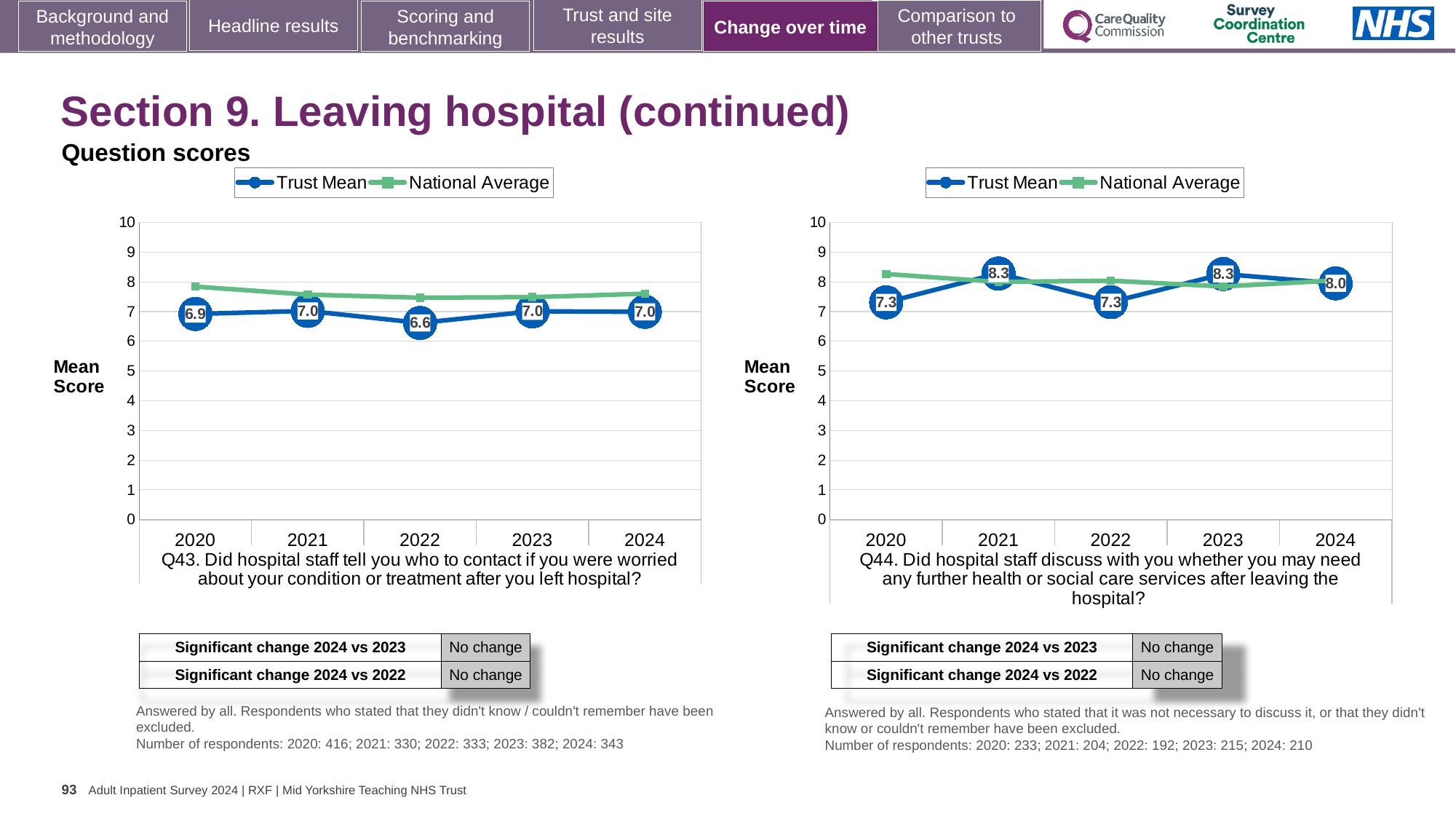
In the Q44 chart on the right, what is the Trust Mean score for 2024? 8.0 In the Q43 chart on the left, is the National Average for 2020 greater or less than 7? greater In the Q43 chart on the left, which is higher in 2022, the Trust Mean or the National Average? National Average In the Q43 chart on the left, what is the Trust Mean score for 2022? 6.6 What kind of chart is the Q43 chart on the left? line chart In the Q44 chart on the right, what is the Trust Mean score for 2021? 8.3 In the Q43 chart on the left, what is the difference between the Trust Mean scores for 2021 and 2022? 0.4 In the Q43 chart on the left, what is the Trust Mean score for 2020? 6.9 In the Q44 chart on the right, does the Trust Mean rise or fall from 2023 to 2024? fall How many series does the legend of the Q44 chart on the right list? 2 In the Q43 chart on the left, which year has the lowest Trust Mean score? 2022 In the Q44 chart on the right, what is the difference between the Trust Mean scores for 2021 and 2020? 1.0